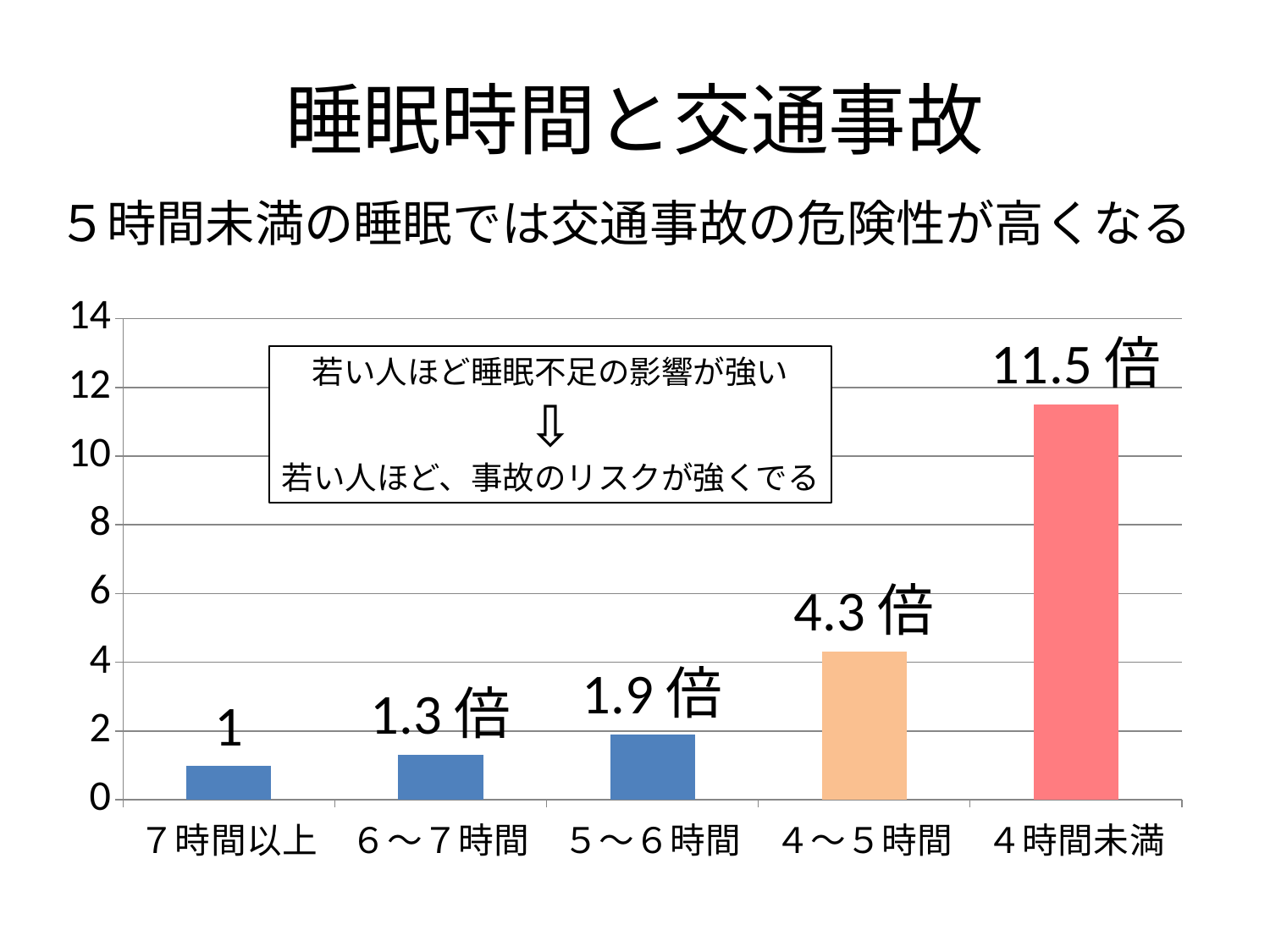
Is the value for 4時間未満 greater or less than 10? greater What is the value shown for 4時間未満? 11.5倍 What is the value shown for 5～6時間? 1.9倍 What is the difference between the values for 4時間未満 and 4～5時間? 7.2 What kind of chart is shown on the slide? bar chart Which is larger, the value for 5～6時間 or the value for 6～7時間? 5～6時間 Do the values rise or fall as sleep duration decreases from left to right along the x axis? rise Which sleep-duration category has the lowest value? 7時間以上 What is the value shown for 6～7時間? 1.3倍 Which sleep-duration category has the highest value? 4時間未満 What is the value shown for 4～5時間? 4.3倍 How many sleep-duration categories are shown on the x axis? 5